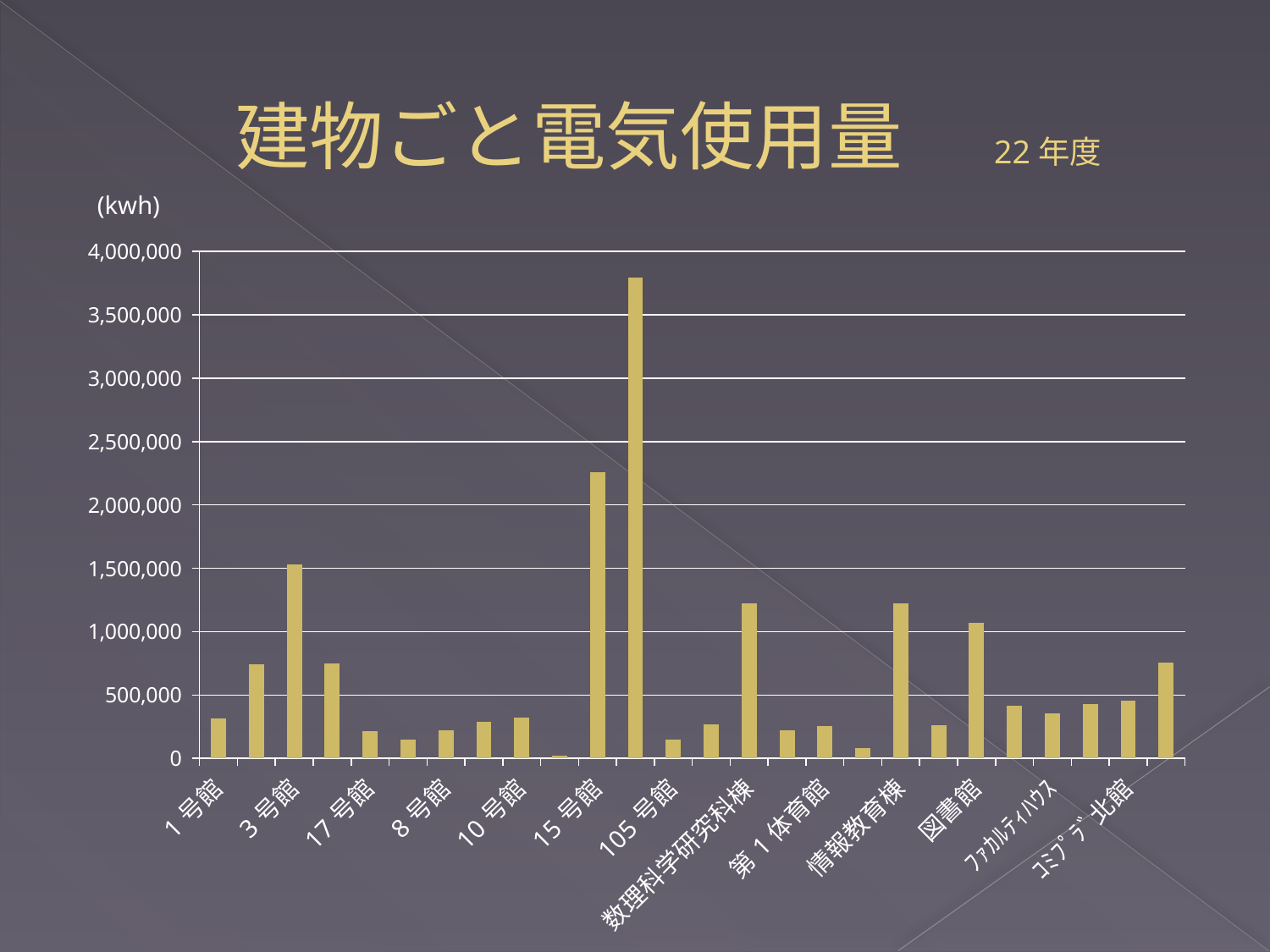
What kind of chart is shown on the slide? bar chart Which has the larger value, 15号館 or 数理科学研究科棟? 15号館 Is the value for 15号館 greater or less than 2,000,000? greater Is the value for 105号館 greater or less than 500,000? less Is the value for 情報教育棟 greater or less than 1,000,000? greater Which has the larger value, 3号館 or 図書館? 3号館 What is the title of the chart? 建物ごと電気使用量 What unit is shown for the values on the chart? kwh Which has the larger value, コミプラ北館 or 17号館? コミプラ北館